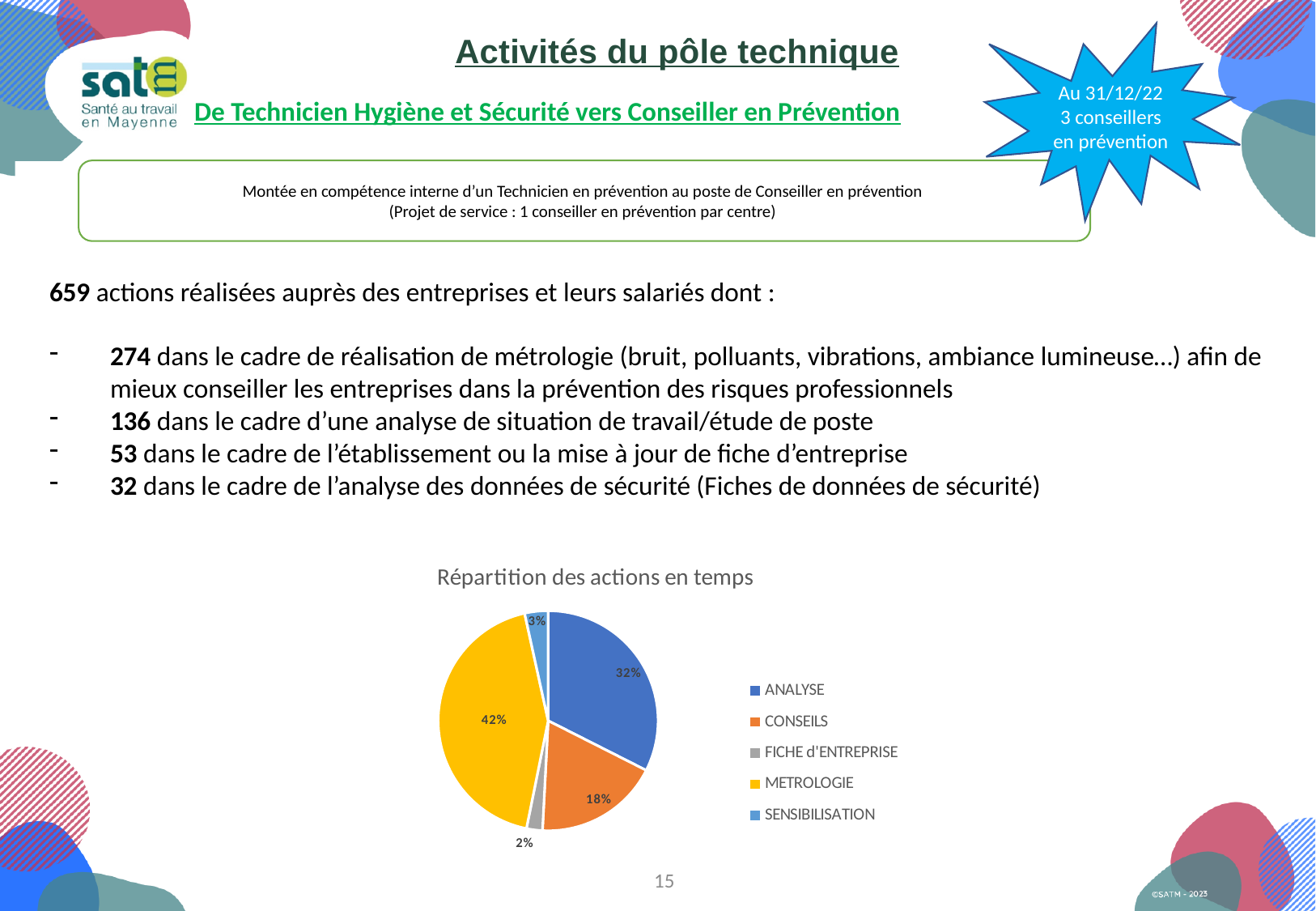
What is the share of FICHE d'ENTREPRISE in the pie chart? 2% What colour is the METROLOGIE slice in the pie chart? yellow What is the share of METROLOGIE in the pie chart? 42% What is the difference in percentage points between the METROLOGIE and ANALYSE slices? 10 What is the share of SENSIBILISATION in the pie chart? 3% Which category has the smallest slice in the pie chart? FICHE d'ENTREPRISE What type of chart is shown under the title "Répartition des actions en temps"? pie chart Which slice is larger, CONSEILS or ANALYSE? ANALYSE How many categories does the pie chart legend list? 5 Which category has the largest slice in the pie chart? METROLOGIE